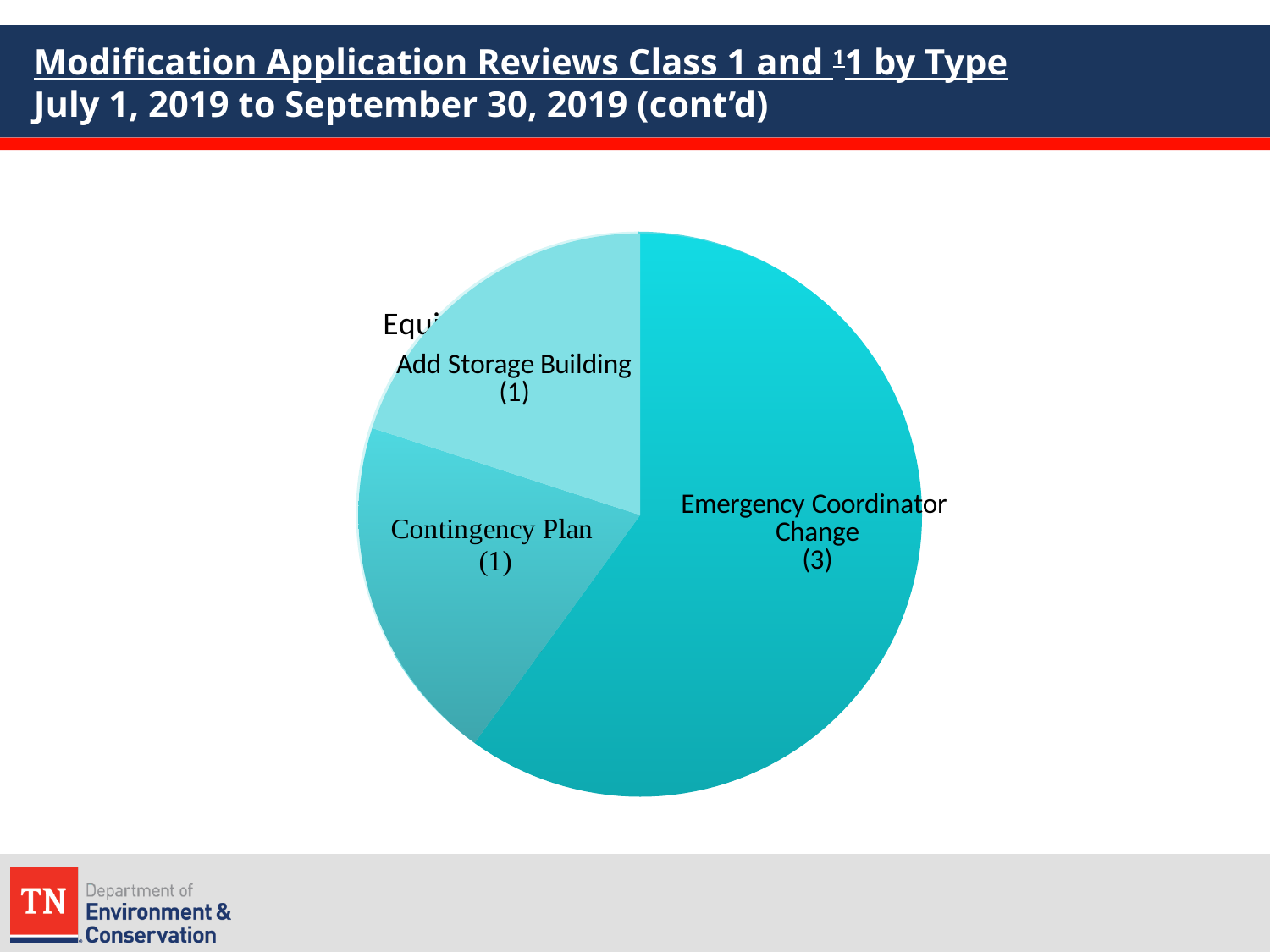
What is the total number of reviews across the labeled slices of the pie chart? 5 How many slices are shown in the pie chart? 3 How many modification application reviews were for Emergency Coordinator Change? 3 What period does the chart title say the data covers? July 1, 2019 to September 30, 2019 What share of the pie does Emergency Coordinator Change represent? 60% What is the difference between the number of Emergency Coordinator Change reviews and Contingency Plan reviews? 2 What type of chart is shown on the slide? pie chart How many modification application reviews were for Contingency Plan? 1 Which is larger, the value for Emergency Coordinator Change or the value for Add Storage Building? Emergency Coordinator Change How many modification application reviews were for Add Storage Building? 1 Which modification type has the largest slice of the pie? Emergency Coordinator Change